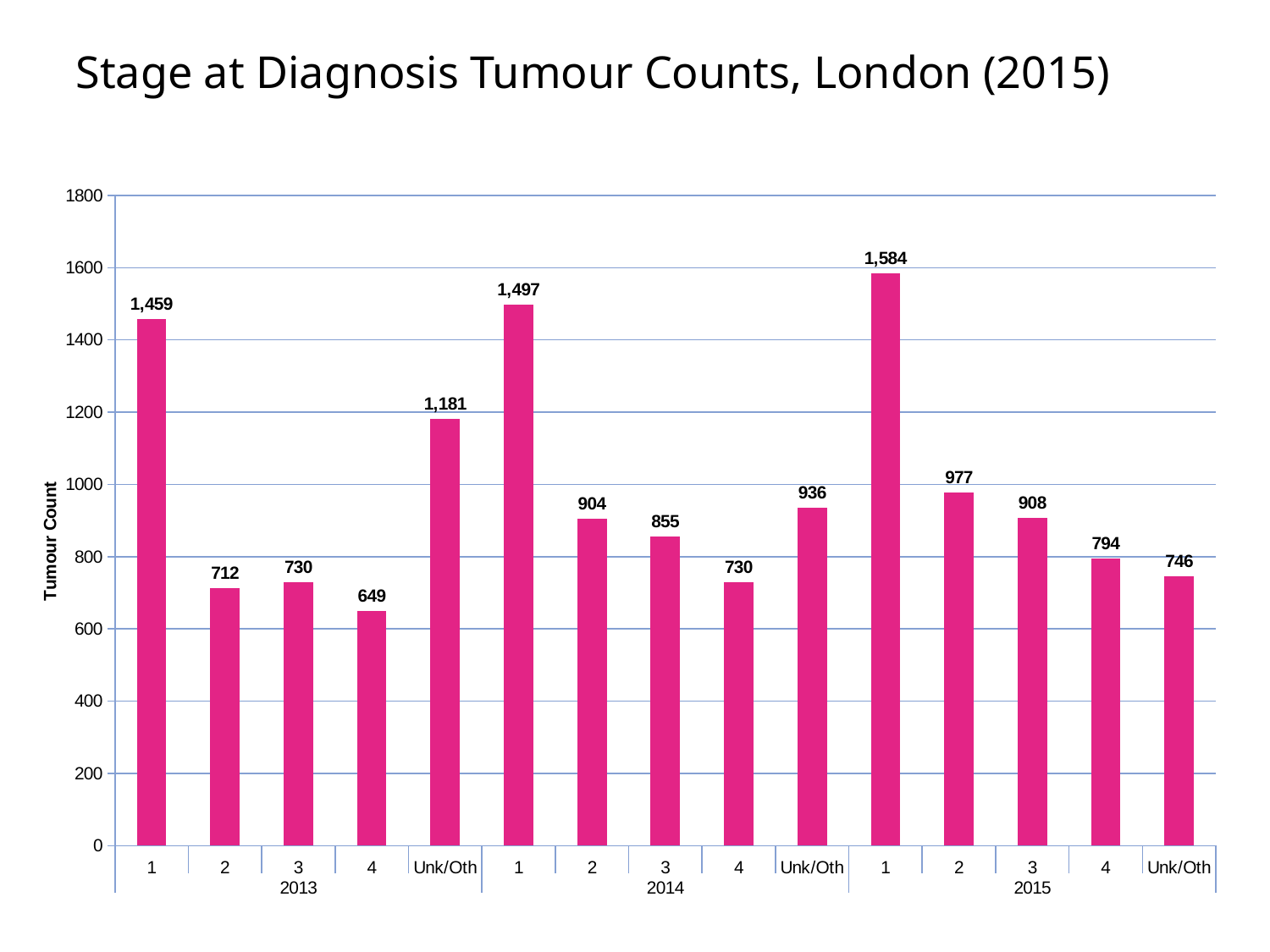
What is the tumour count for stage 1 in 2013? 1,459 Which bar has the lowest tumour count? Stage 4, 2013 What is the tumour count for stage 4 in 2015? 794 What is the label on the vertical axis? Tumour Count What is the tumour count for Unk/Oth in 2014? 936 Is the value for Unk/Oth in 2013 greater or less than 1000? greater What is the title of the chart? Stage at Diagnosis Tumour Counts, London (2015) Which is larger, the stage 2 count in 2014 or the stage 2 count in 2015? Stage 2 in 2015 What kind of chart is shown? Bar chart Which bar has the highest tumour count? Stage 1, 2015 How many bars are plotted on the chart? 15 What is the difference between the stage 1 counts in 2015 and 2014? 87